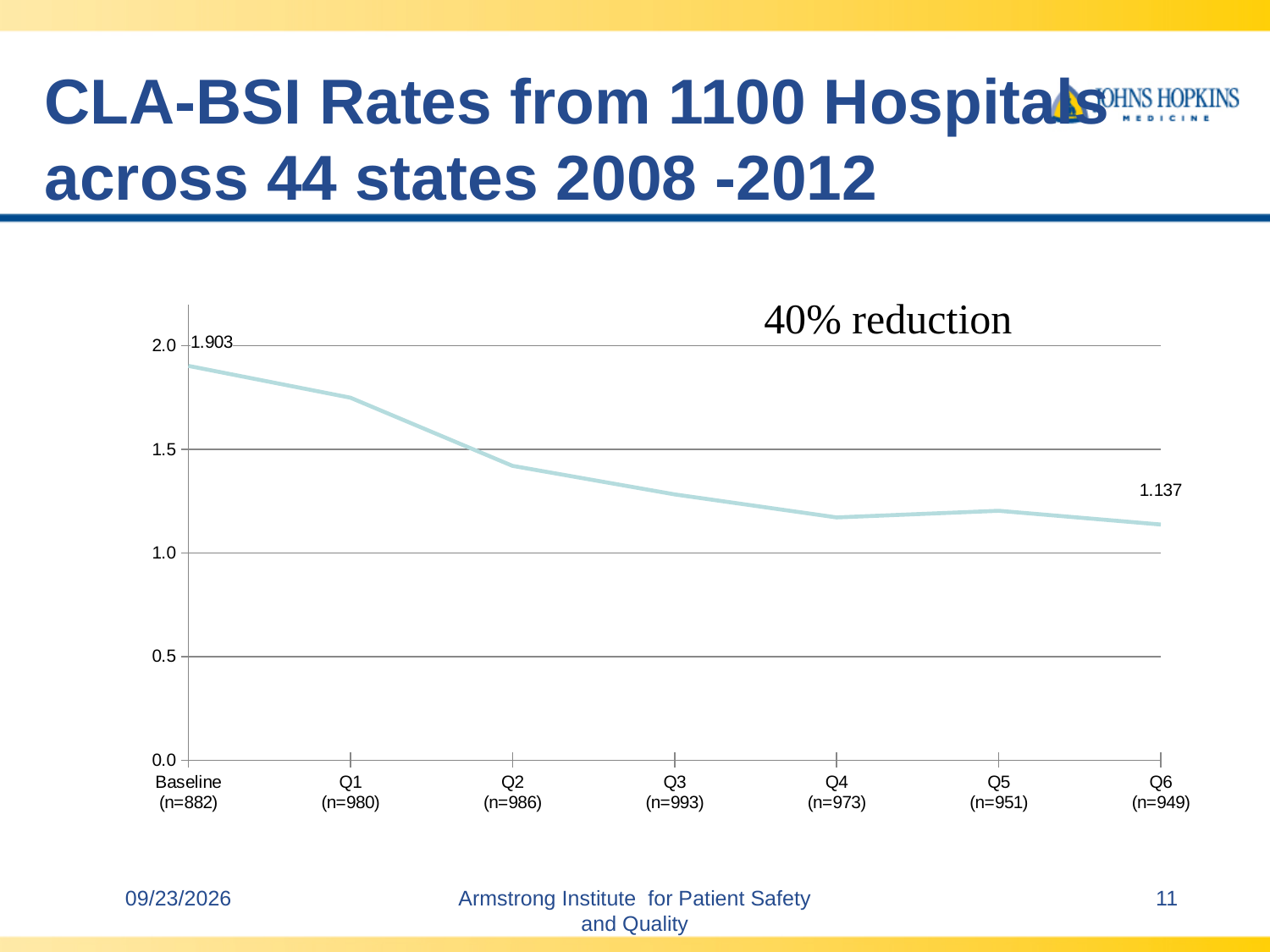
Which period has the highest CLA-BSI rate? Baseline Is the value for Q1 greater or less than 1.5? greater What kind of chart is shown on the slide? line chart Which is larger, the rate at Q1 or the rate at Q3? Q1 Is the value for Q4 greater or less than 1.0? greater What is the CLA-BSI rate at Baseline? 1.903 Is the value for Q2 greater or less than 1.5? less What is the difference between the Baseline rate and the Q6 rate? 0.766 What is the CLA-BSI rate at Q6? 1.137 Which is larger, the rate at Baseline or the rate at Q6? Baseline Do the CLA-BSI rates generally rise or fall from Baseline to Q6? fall How many time periods are plotted on the x axis? 7